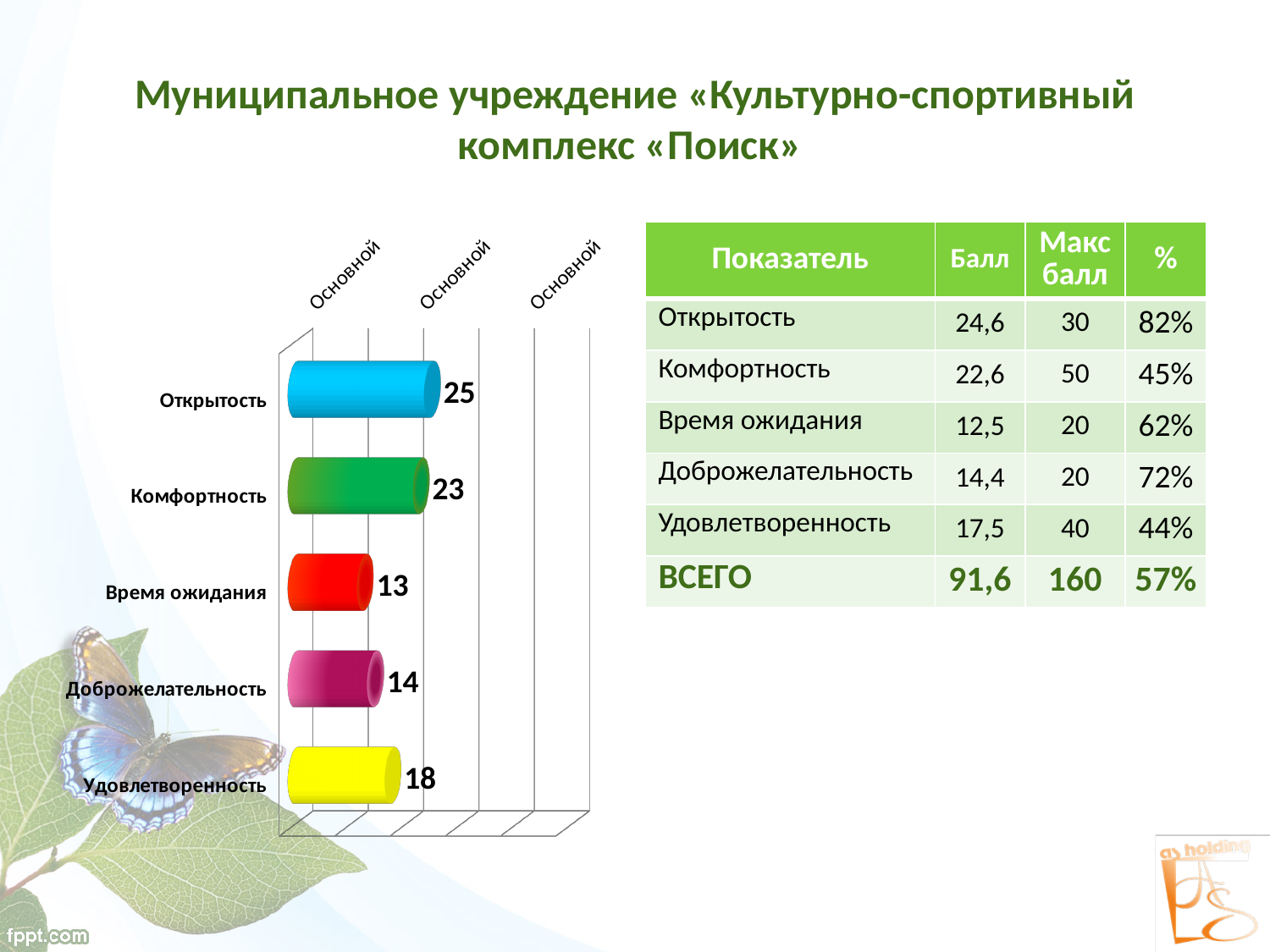
How many categories are plotted in the bar chart? 5 What value is shown for Время ожидания in the bar chart? 13 Which category has the lowest value in the bar chart? Время ожидания Which is larger in the bar chart, the value for Удовлетворенность or the value for Доброжелательность? Удовлетворенность Which category has the highest value in the bar chart? Открытость What kind of chart is shown on the slide? Bar chart What is the difference between the values for Открытость and Удовлетворенность in the bar chart? 7 What colour is the bar for Удовлетворенность in the chart? Yellow What value is shown for Открытость in the bar chart? 25 What value is shown for Комфортность in the bar chart? 23 What value is shown for Доброжелательность in the bar chart? 14 What value is shown for Удовлетворенность in the bar chart? 18